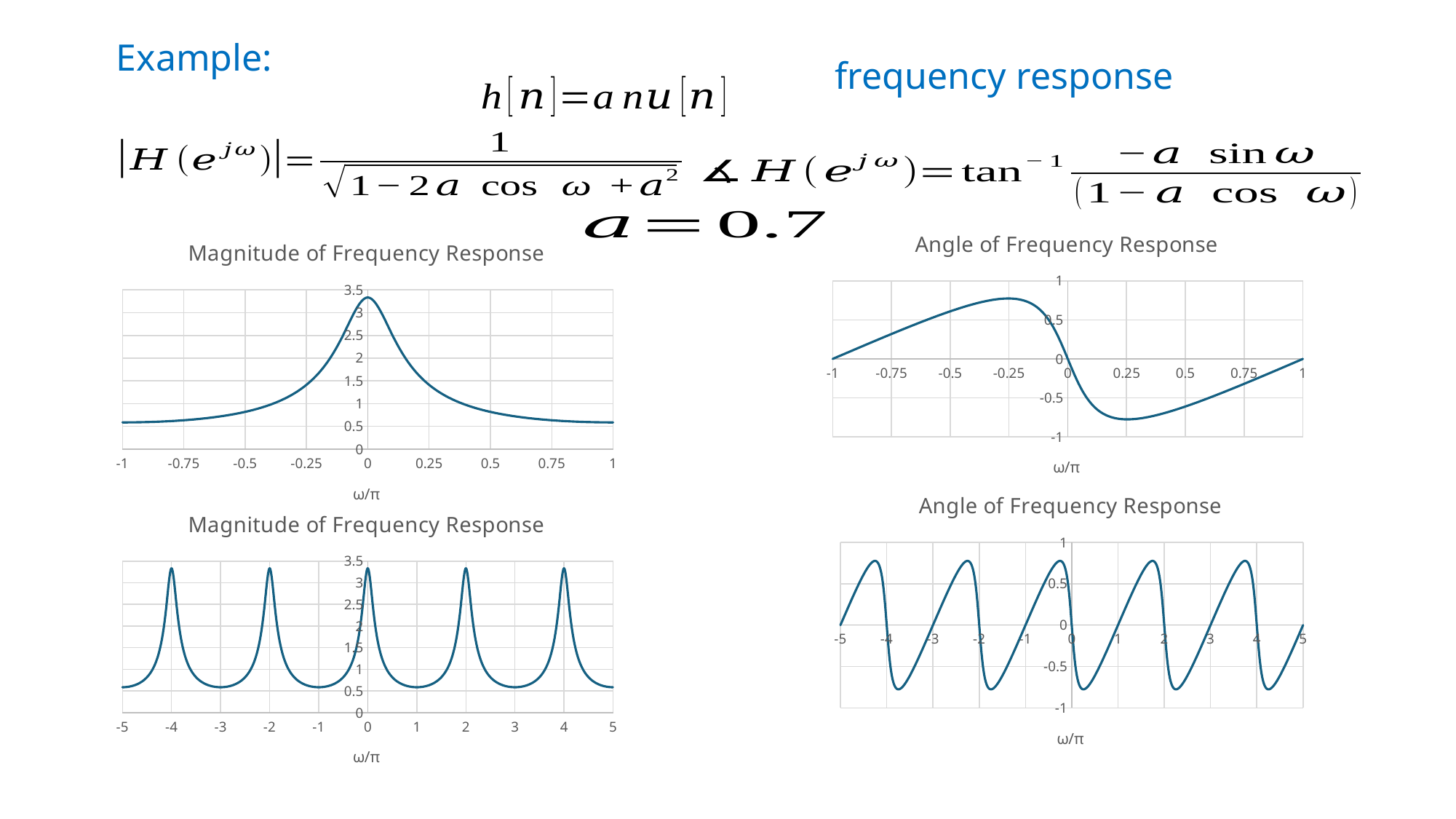
In the top-right 'Angle of Frequency Response' chart, is the value at ω/π = 0.25 greater or less than -0.5? less In the top-left 'Magnitude of Frequency Response' chart, is the value at ω/π = -1 greater or less than 1? less In the top-left 'Magnitude of Frequency Response' chart, is the value at ω/π = 0 greater or less than 3? greater What is the x-axis label on the bottom-right 'Angle of Frequency Response' chart? ω/π In the top-left 'Magnitude of Frequency Response' chart, does the curve rise or fall as ω/π goes from 0 to 1? fall In the bottom-left 'Magnitude of Frequency Response' chart, how many peaks does the curve show between ω/π = -5 and 5? 5 In the top-right 'Angle of Frequency Response' chart, does the curve rise or fall as ω/π goes from -1 to -0.25? rise What kind of chart is the top-left 'Magnitude of Frequency Response' chart? line chart How many charts are shown on the slide? 4 In the top-left 'Magnitude of Frequency Response' chart, at what value of ω/π does the curve reach its peak? 0